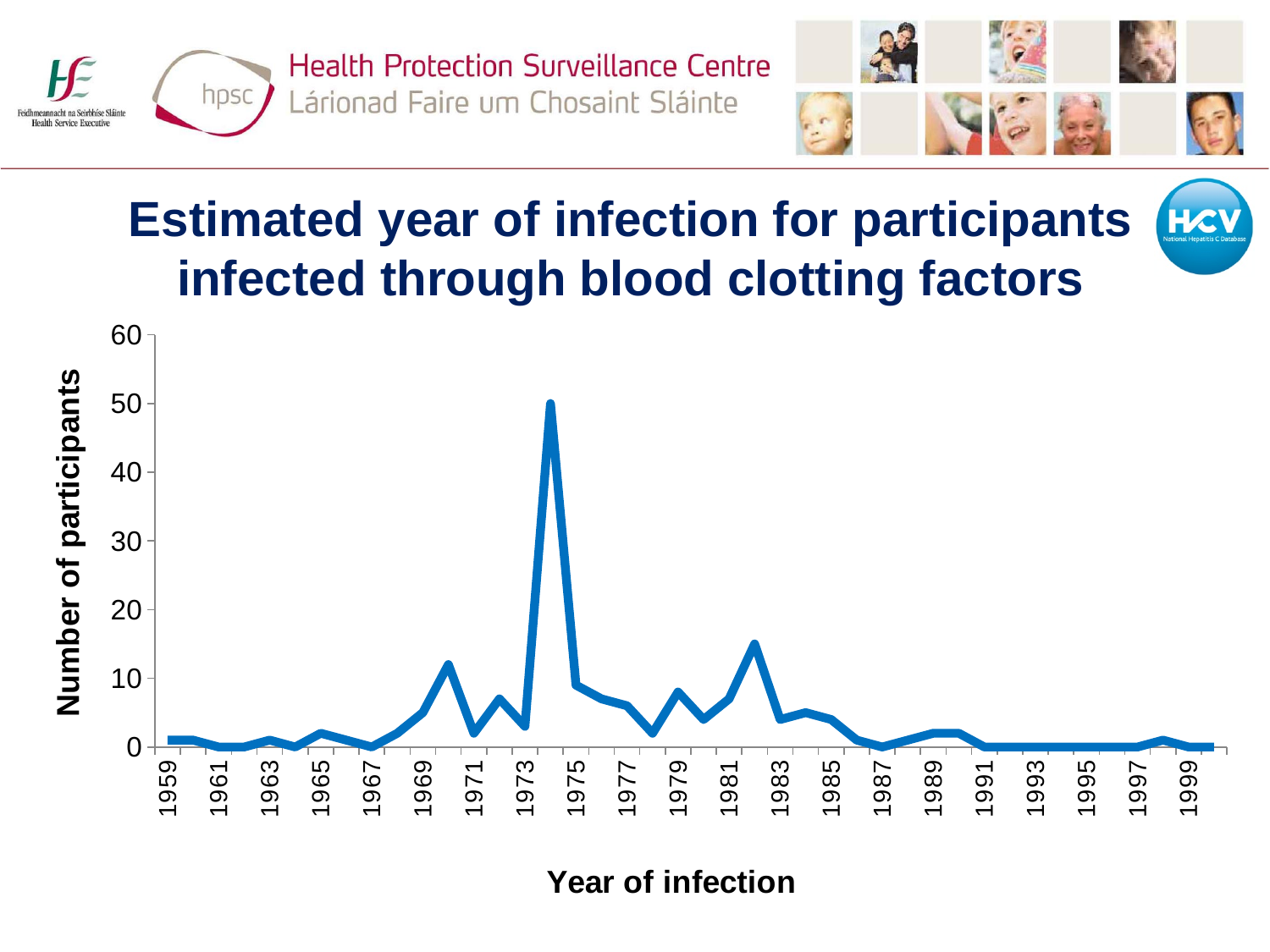
Is the number of participants for 1970 greater or less than 10? greater What is the label on the x axis of the chart? Year of infection Which year has more participants, 1974 or 1982? 1974 What is the label on the y axis of the chart? Number of participants Is the number of participants for 1982 greater or less than 10? greater In which year of infection does the number of participants reach its highest value? 1974 Do the values rise or fall between 1982 and 1987? fall Is the number of participants for 1987 greater or less than 10? less What kind of chart is shown on the slide? line chart Which year has more participants, 1970 or 1965? 1970 What is the number of participants for the peak year 1974? 50